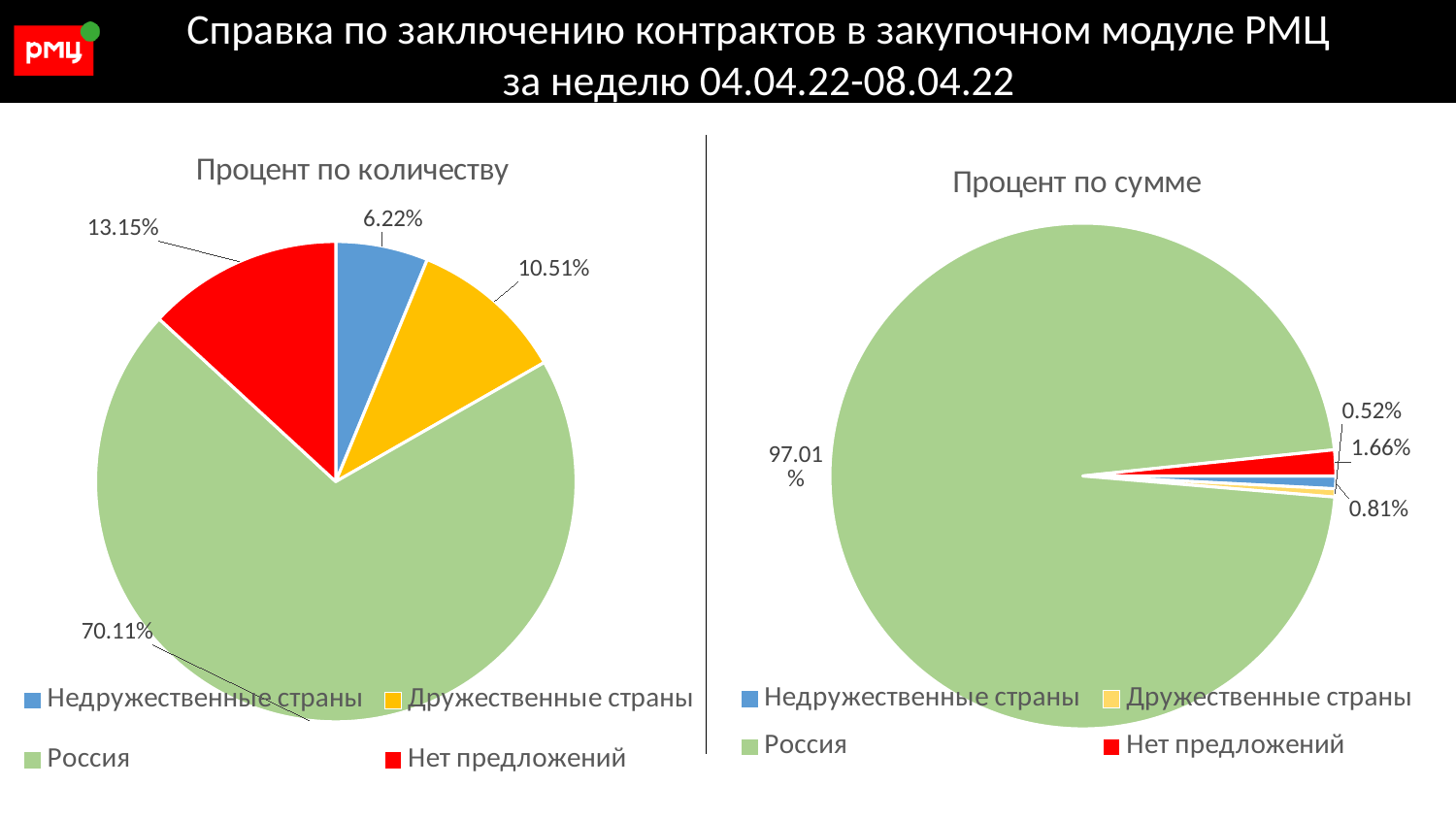
In the chart titled 'Процент по сумме', which category has the largest slice? Россия In the chart titled 'Процент по количеству', what is the difference between the shares of Нет предложений and Недружественные страны? 6.93% In the chart titled 'Процент по количеству', what is the share for Нет предложений? 13.15% In the chart titled 'Процент по количеству', what is the share for Дружественные страны? 10.51% In the chart titled 'Процент по количеству', which category has the smallest slice? Недружественные страны How many categories does the legend of the chart titled 'Процент по количеству' list? 4 In the chart titled 'Процент по количеству', which is larger: Нет предложений or Дружественные страны? Нет предложений In the chart titled 'Процент по количеству', what is the share for Россия? 70.11% In the chart titled 'Процент по количеству', what colour is the slice for Нет предложений? Red What type of chart is the chart titled 'Процент по сумме'? Pie chart In the chart titled 'Процент по количеству', what is the share for Недружественные страны? 6.22% In the chart titled 'Процент по сумме', what is the share for Россия? 97.01%